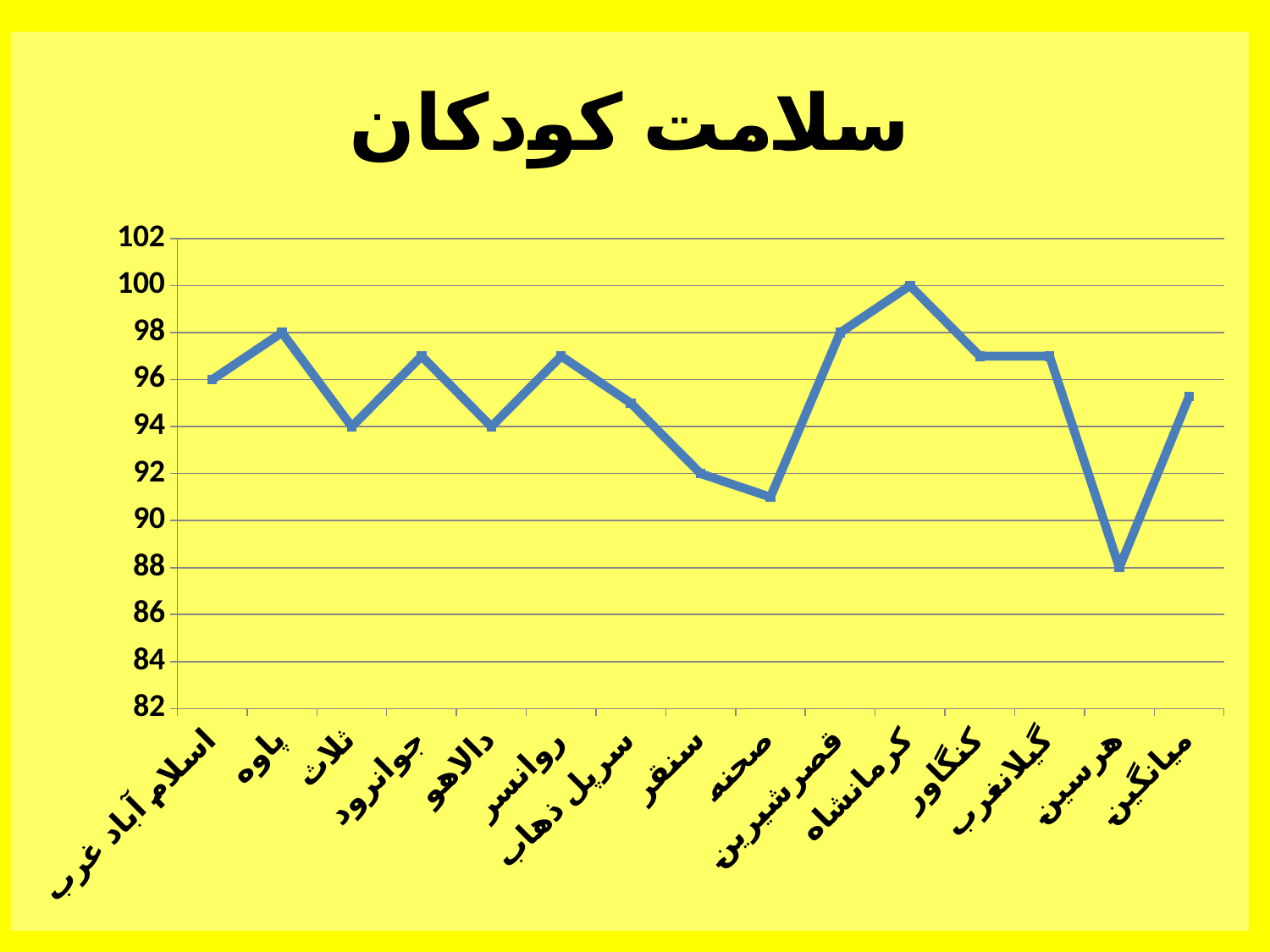
Do the values rise or fall from کرمانشاه to هرسین along the x axis? fall What is the value for کرمانشاه? 100 Which category has the lowest value? هرسین What is the value for پاوه? 98 Which category has the highest value? کرمانشاه What is the difference between the values for کرمانشاه and هرسین? 12 Which is larger, the value for پاوه or the value for ثلاث? پاوه How many categories are plotted along the x axis? 15 What is the value for هرسین? 88 Is the value for صحنه greater or less than 92? less What kind of chart is shown on the slide? line chart What is the title of the chart? سلامت کودکان